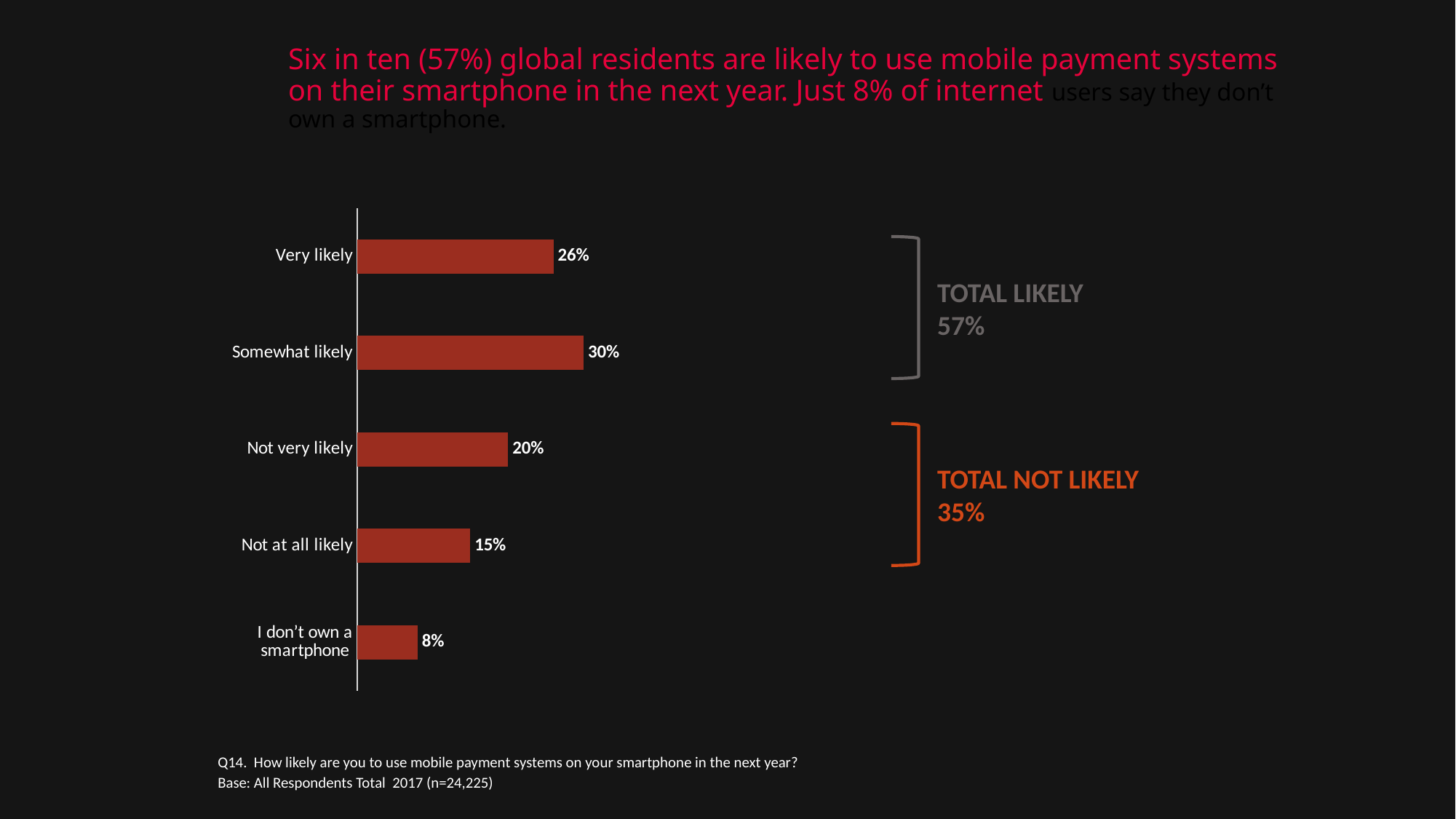
Which category has the lowest value? I don't own a smartphone What kind of chart is shown on the slide? Bar chart What is the value for 'Not at all likely'? 15% What is the value for 'Somewhat likely'? 30% What is the difference between 'Not very likely' and 'Not at all likely'? 5% How many categories are shown in the chart? 5 Which is larger, the value for 'Not very likely' or the value for 'Not at all likely'? Not very likely What percentage of respondents are very likely to use mobile payment systems on their smartphone in the next year? 26% What is the 'TOTAL NOT LIKELY' figure shown next to the chart? 35% What percentage of respondents say they don't own a smartphone? 8% What is the difference between the 'Somewhat likely' and 'Very likely' values? 4% Which category has the highest value? Somewhat likely